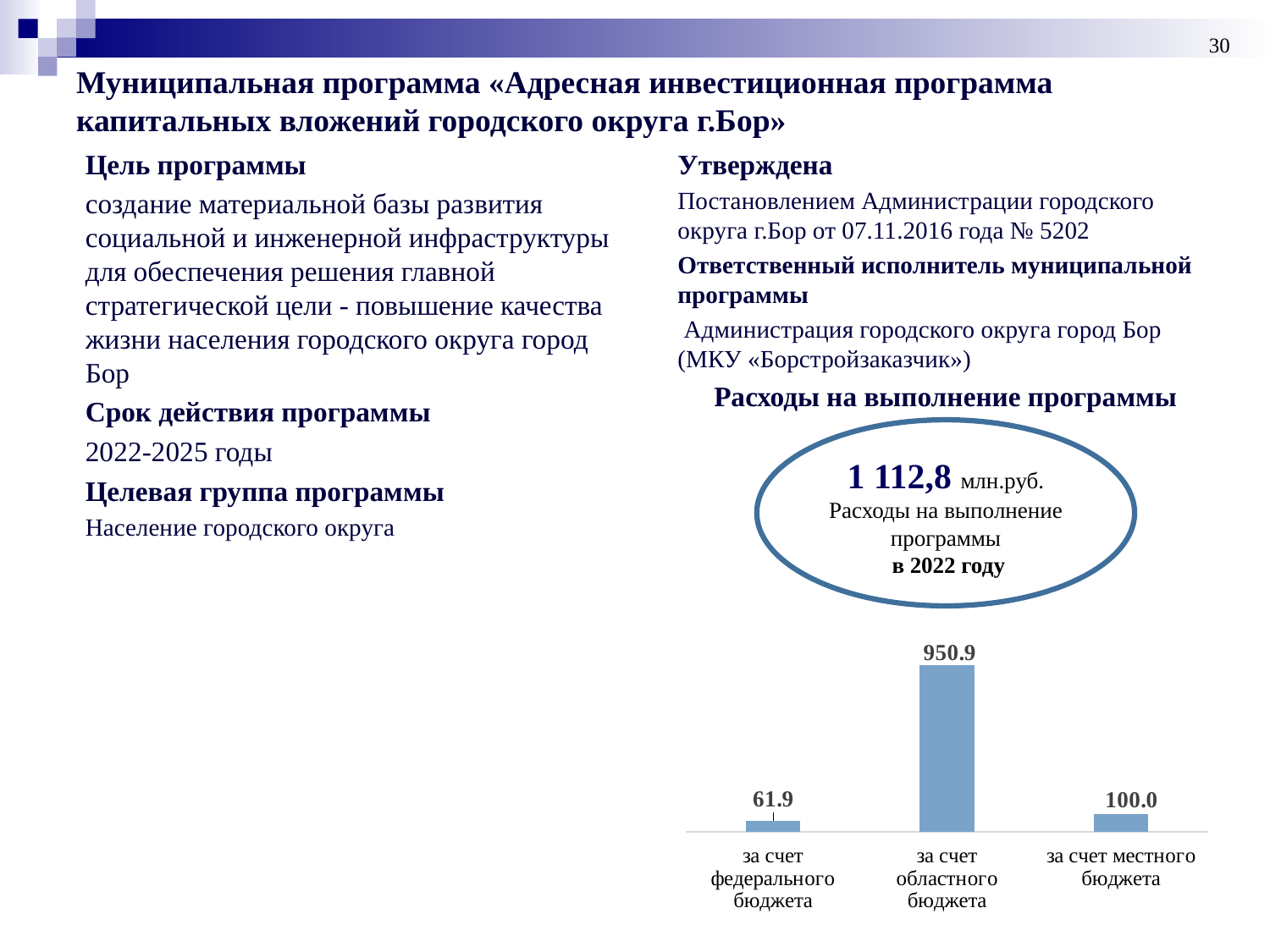
How many categories are shown in the chart? 3 What is the value for 'за счет областного бюджета'? 950.9 Which category has the lowest value? за счет федерального бюджета What is the total of the three values shown in the chart? 1112.8 What is the value for 'за счет местного бюджета'? 100.0 What kind of chart is shown on the slide? bar chart What is the value for 'за счет федерального бюджета'? 61.9 What is the title above the chart? Расходы на выполнение программы Which category has the highest value? за счет областного бюджета What is the difference between the values for 'за счет местного бюджета' and 'за счет федерального бюджета'? 38.1 Which is larger, the value for 'за счет местного бюджета' or 'за счет федерального бюджета'? за счет местного бюджета What is the difference between the values for 'за счет областного бюджета' and 'за счет местного бюджета'? 850.9